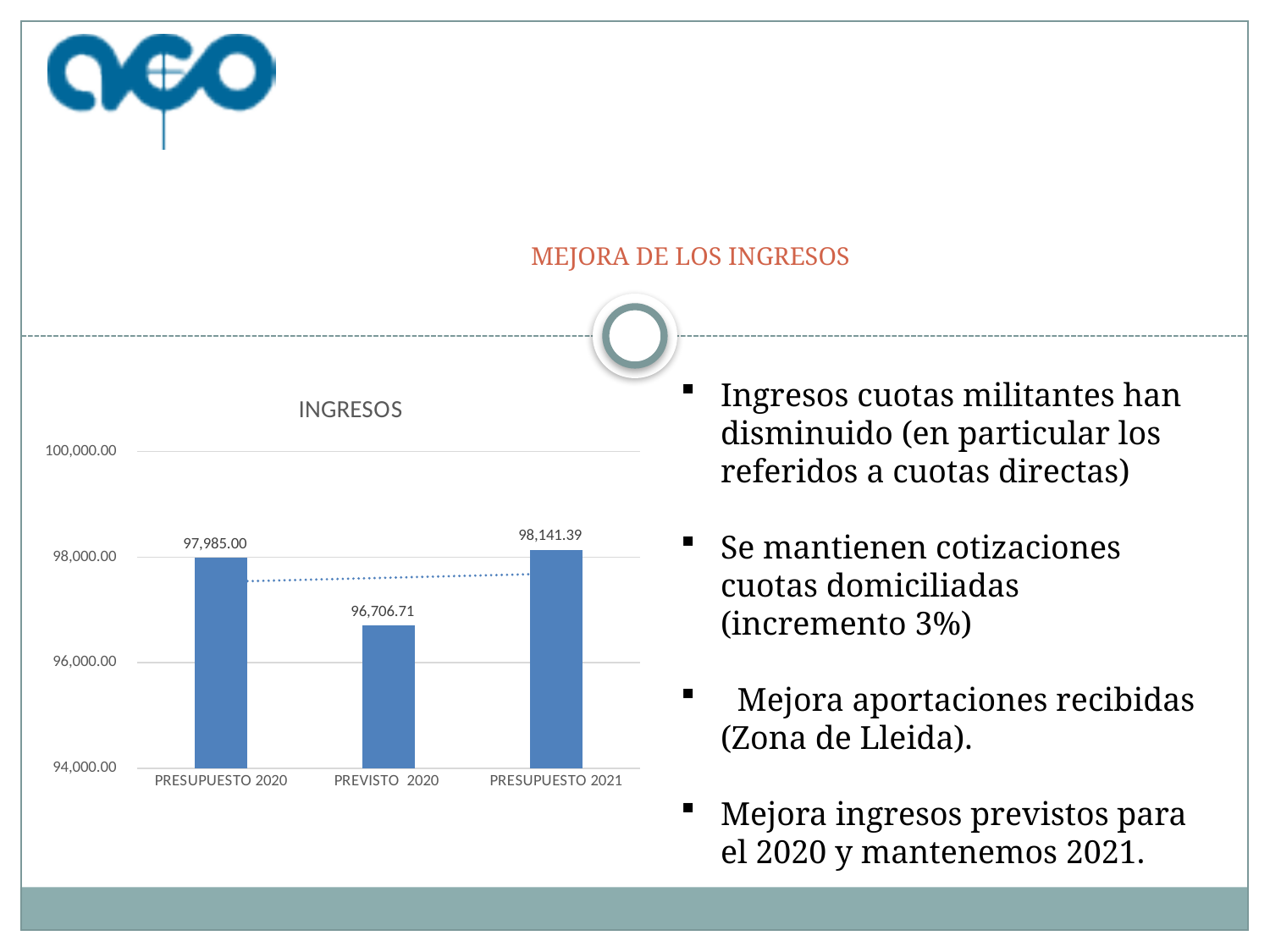
What is the title of the chart on the slide? INGRESOS Is the value for PREVISTO 2020 greater or less than 98,000.00? less What is the difference between PRESUPUESTO 2020 and PREVISTO 2020 in the INGRESOS chart? 1,278.29 Which category has the highest value in the INGRESOS chart? PRESUPUESTO 2021 What kind of chart is the INGRESOS chart? bar chart What is the value for PREVISTO 2020 in the INGRESOS chart? 96,706.71 What is the difference between PRESUPUESTO 2021 and PRESUPUESTO 2020 in the INGRESOS chart? 156.39 What is the value for PRESUPUESTO 2021 in the INGRESOS chart? 98,141.39 How many categories are shown in the INGRESOS chart? 3 Which category has the lowest value in the INGRESOS chart? PREVISTO 2020 Which is larger in the INGRESOS chart, PREVISTO 2020 or PRESUPUESTO 2021? PRESUPUESTO 2021 What is the value for PRESUPUESTO 2020 in the INGRESOS chart? 97,985.00